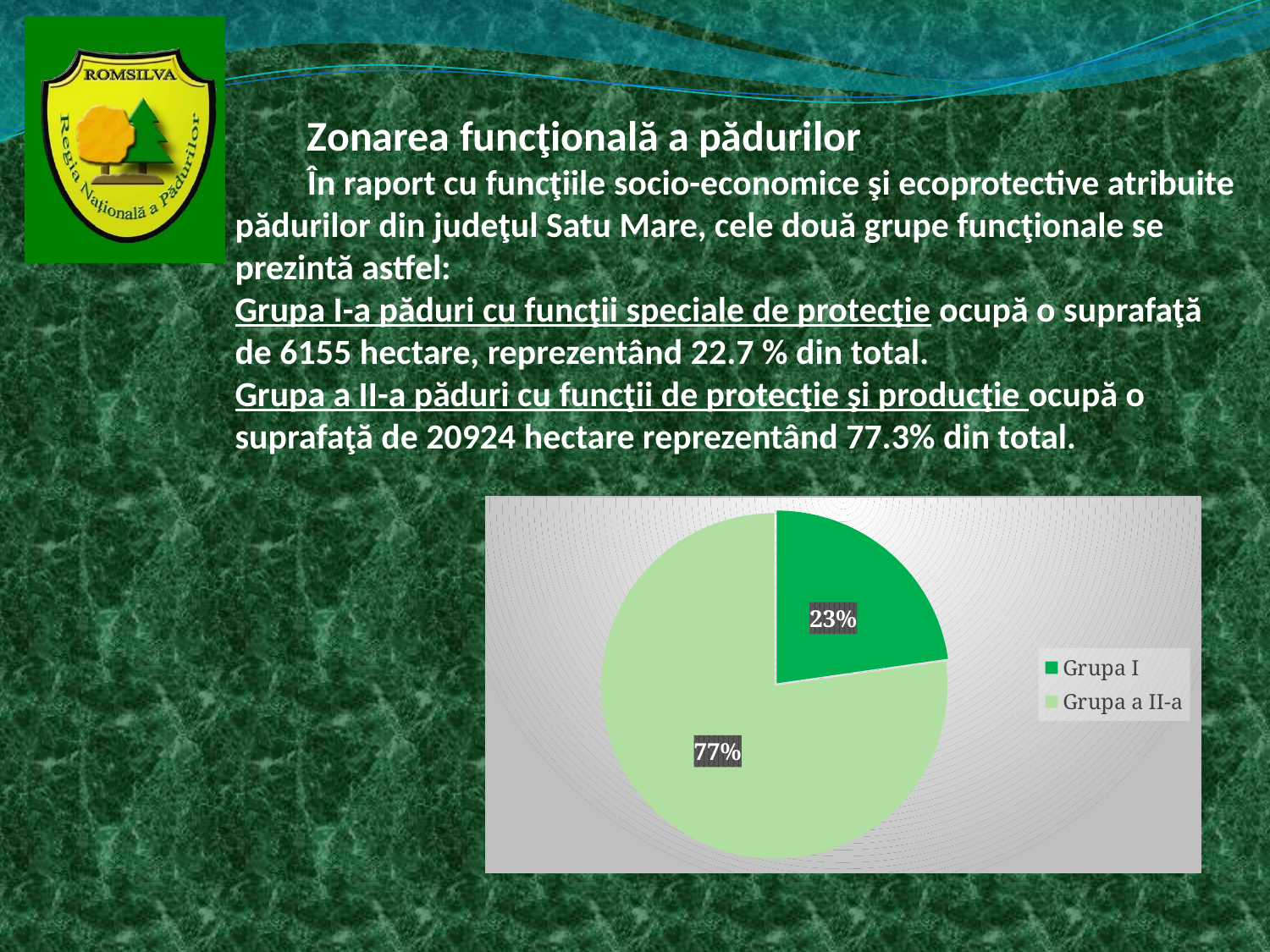
What is the difference in percentage points between the Grupa a II-a slice and the Grupa I slice? 54% How many slices does the pie chart have? 2 Which legend entry is shown in the darker green colour? Grupa I What share of the pie does Grupa a II-a represent? 77% Which slice of the pie is the smallest? Grupa I Which slice of the pie is the largest? Grupa a II-a Which is larger, the slice for Grupa I or the slice for Grupa a II-a? Grupa a II-a What kind of chart is shown on the slide? pie chart How many entries does the legend list? 2 What are the two entries listed in the legend? Grupa I and Grupa a II-a What share of the pie does Grupa I represent? 23%